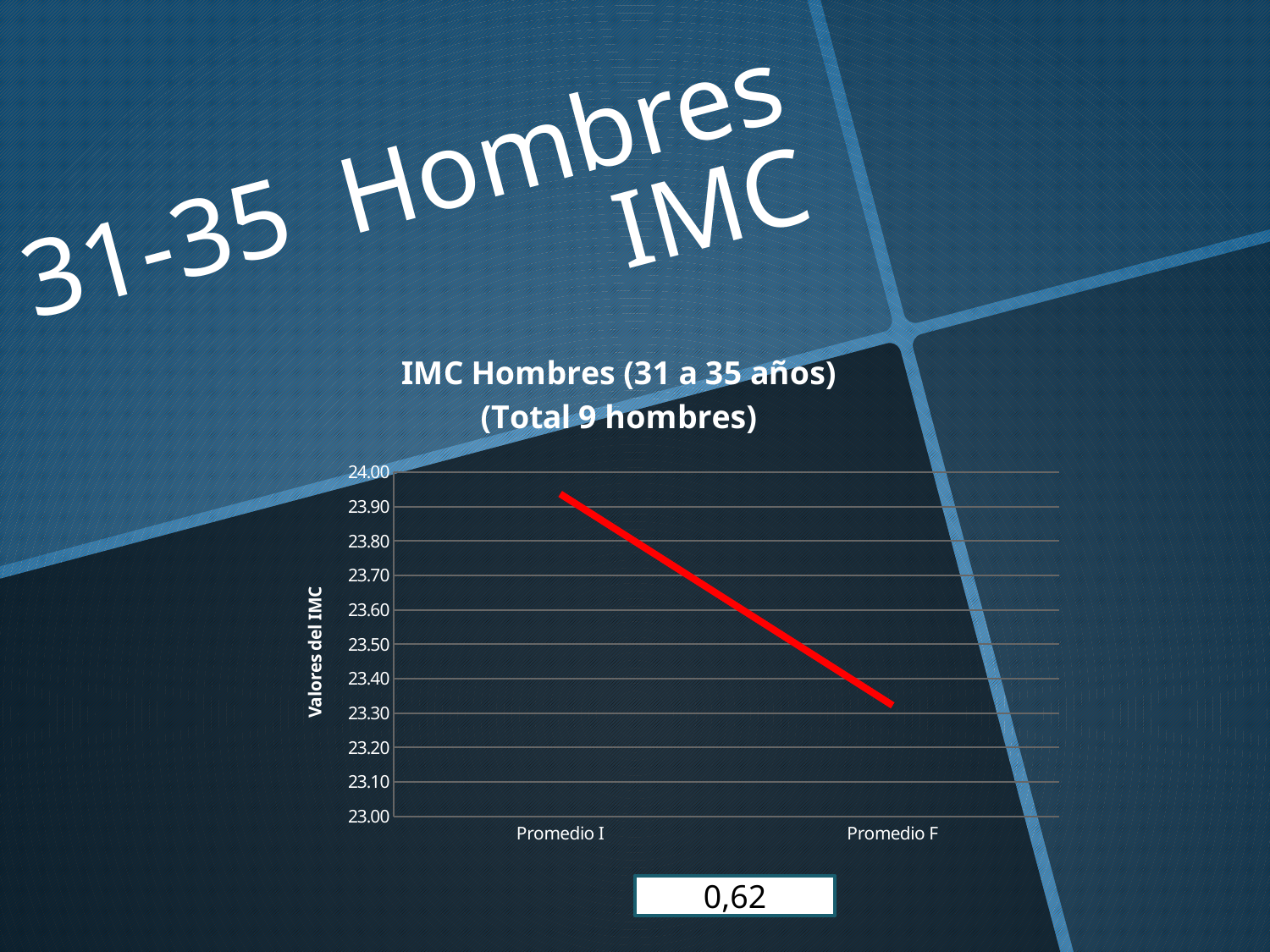
Is the value for Promedio I greater or less than 23.80? greater Which category has the highest value on the chart? Promedio I What is the label of the y axis of the chart? Valores del IMC What is the title of the chart? IMC Hombres (31 a 35 años) (Total 9 hombres) What kind of chart is shown on the slide? line chart What is the highest value shown on the y axis of the chart? 24.00 Is the value for Promedio F greater or less than 23.50? less Which category has the higher value, Promedio I or Promedio F? Promedio I Which category has the lowest value on the chart? Promedio F Is the value for Promedio F greater or less than 23.20? greater Do the values rise or fall from Promedio I to Promedio F? fall How many categories are shown on the x axis of the chart? 2